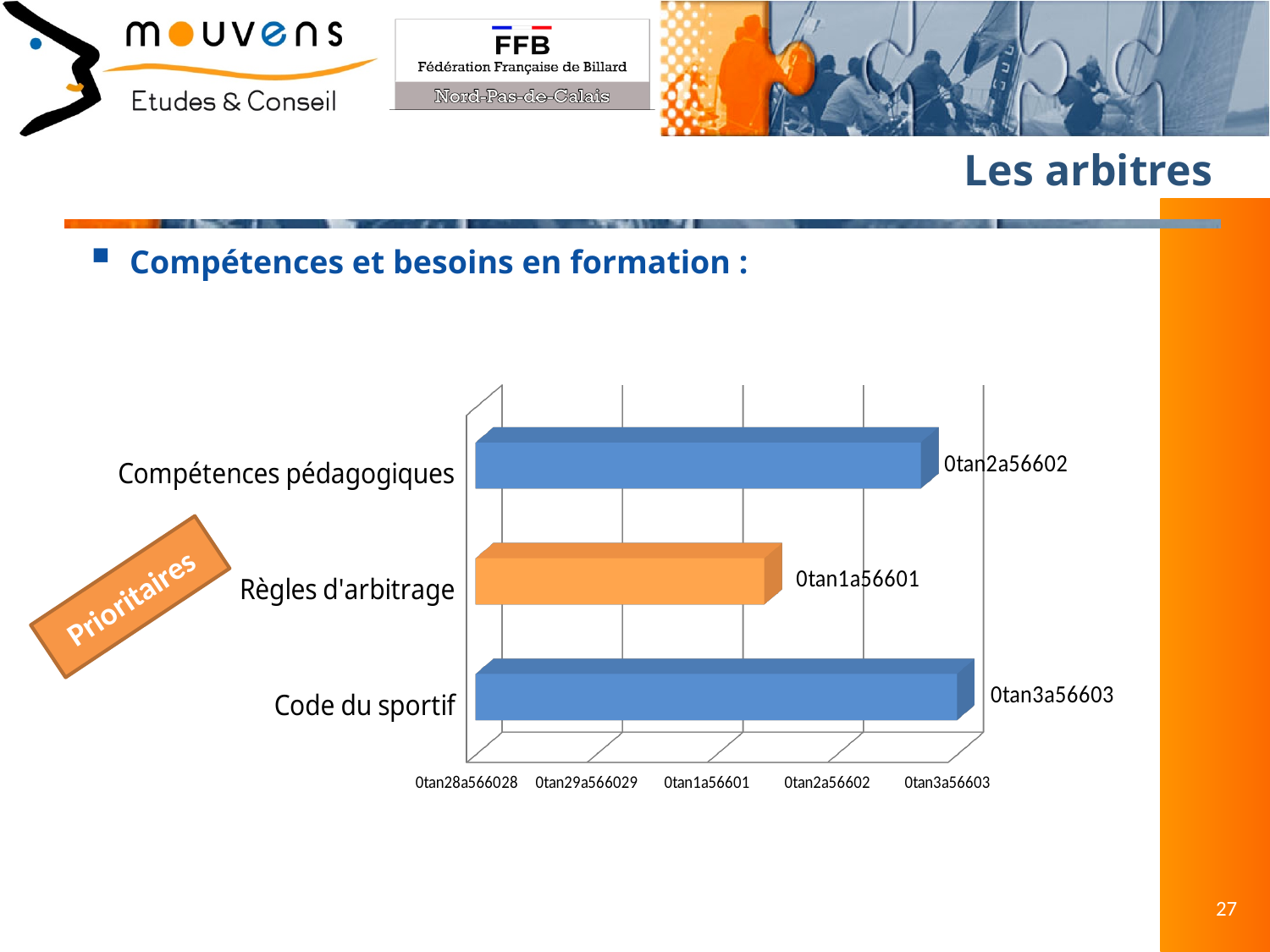
What kind of chart is shown on the slide? bar chart Are the bars in the chart horizontal or vertical? horizontal What word appears on the tilted orange label next to the chart? Prioritaires Which category has the shortest bar in the chart? Règles d'arbitrage Which bar is longer: Compétences pédagogiques or Règles d'arbitrage? Compétences pédagogiques How many categories are plotted in the chart? 3 Which category's bar is coloured orange rather than blue? Règles d'arbitrage Which category has the longest bar in the chart? Code du sportif Which bar is longer: Code du sportif or Compétences pédagogiques? Code du sportif Which bar is longer: Code du sportif or Règles d'arbitrage? Code du sportif